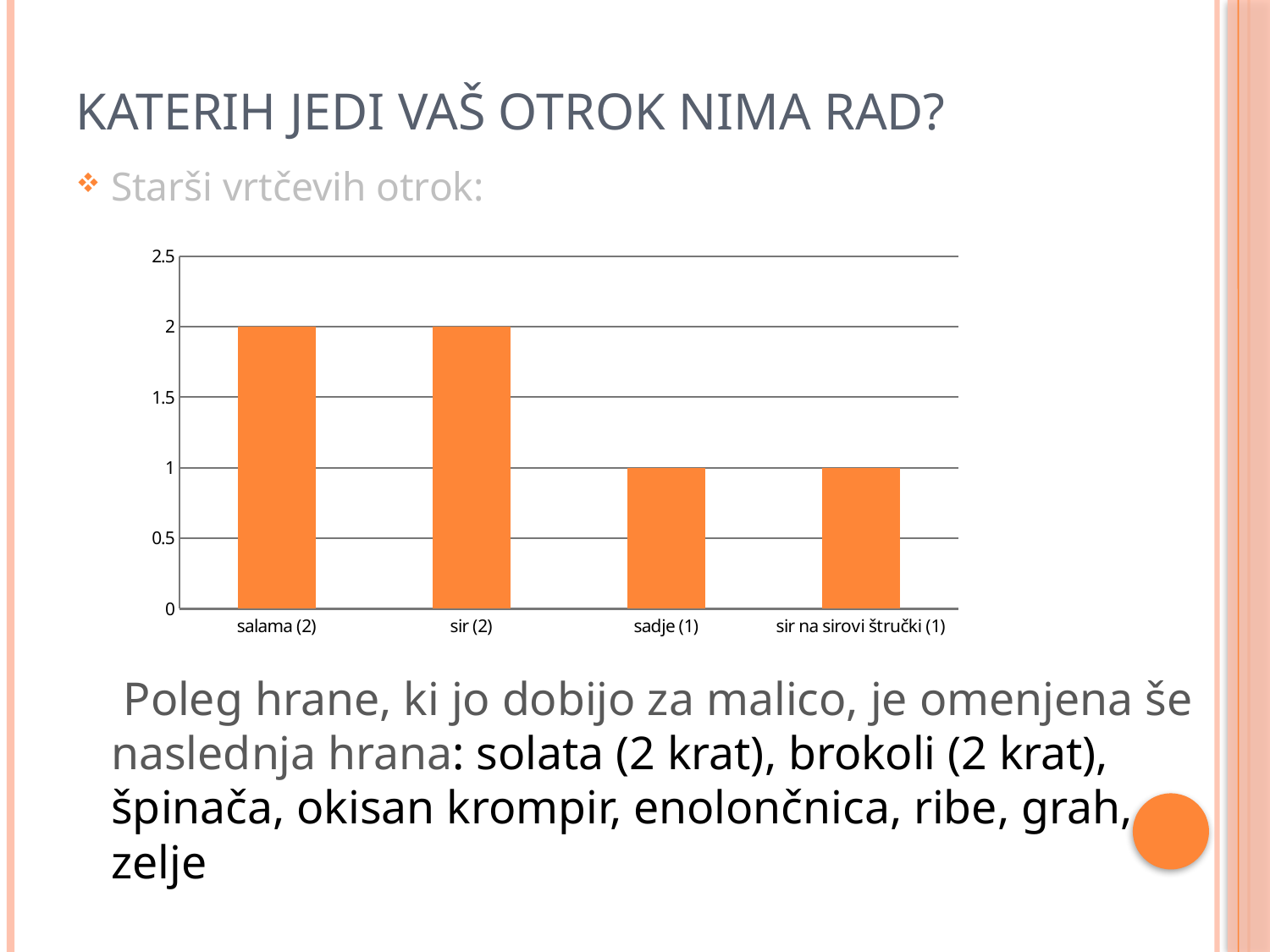
How many categories are shown on the x axis of the chart? 4 What is the difference between the values for salama (2) and sadje (1)? 1 Is the value for sir na sirovi štručki (1) greater or less than 1.5? less What colour are the bars in the chart? orange Which category has the lowest value, sir (2) or sadje (1)? sadje (1) What is the value for sir na sirovi štručki (1)? 1 Do the bar values rise or fall from left to right along the x axis? fall What is the highest value shown on the y axis of the chart? 2.5 What is the value for sadje (1)? 1 Is the value for sir (2) greater or less than 1.5? greater What kind of chart is shown on the slide? bar chart What is the value for salama (2)? 2